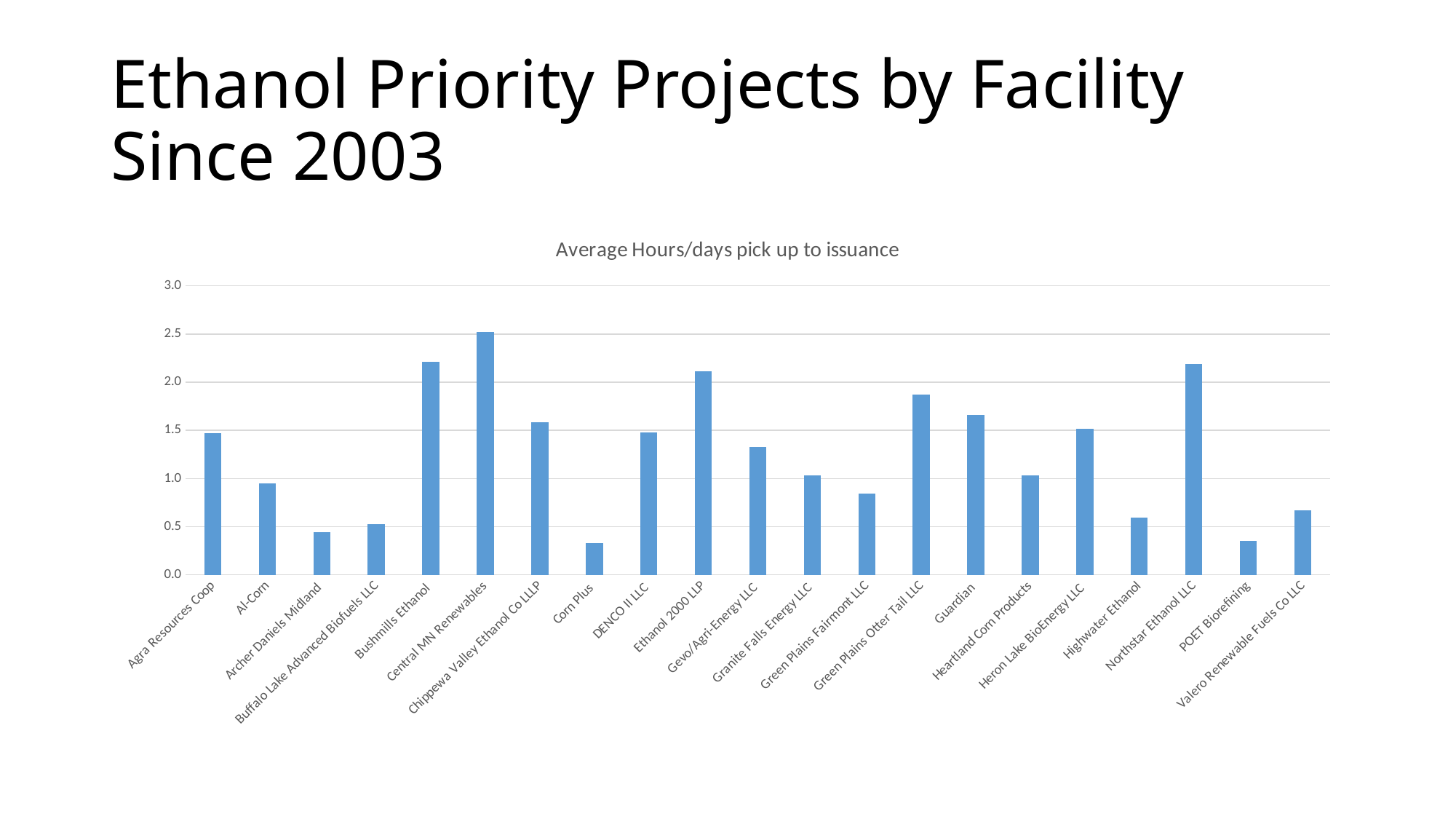
Which has the larger value, Heron Lake BioEnergy LLC or Highwater Ethanol? Heron Lake BioEnergy LLC What is the title of the chart? Average Hours/days pick up to issuance Which has the larger value, Green Plains Otter Tail LLC or Guardian? Green Plains Otter Tail LLC Which facility has the highest value in the chart? Central MN Renewables Is the value for Northstar Ethanol LLC greater or less than 2.0? greater Is the value for Green Plains Fairmont LLC greater or less than 1.0? less Which has the larger value, Al-Corn or Archer Daniels Midland? Al-Corn Is the value for Gevo/Agri-Energy LLC greater or less than 1.5? less What kind of chart is shown on the slide? bar chart How many facilities are shown on the x axis of the chart? 21